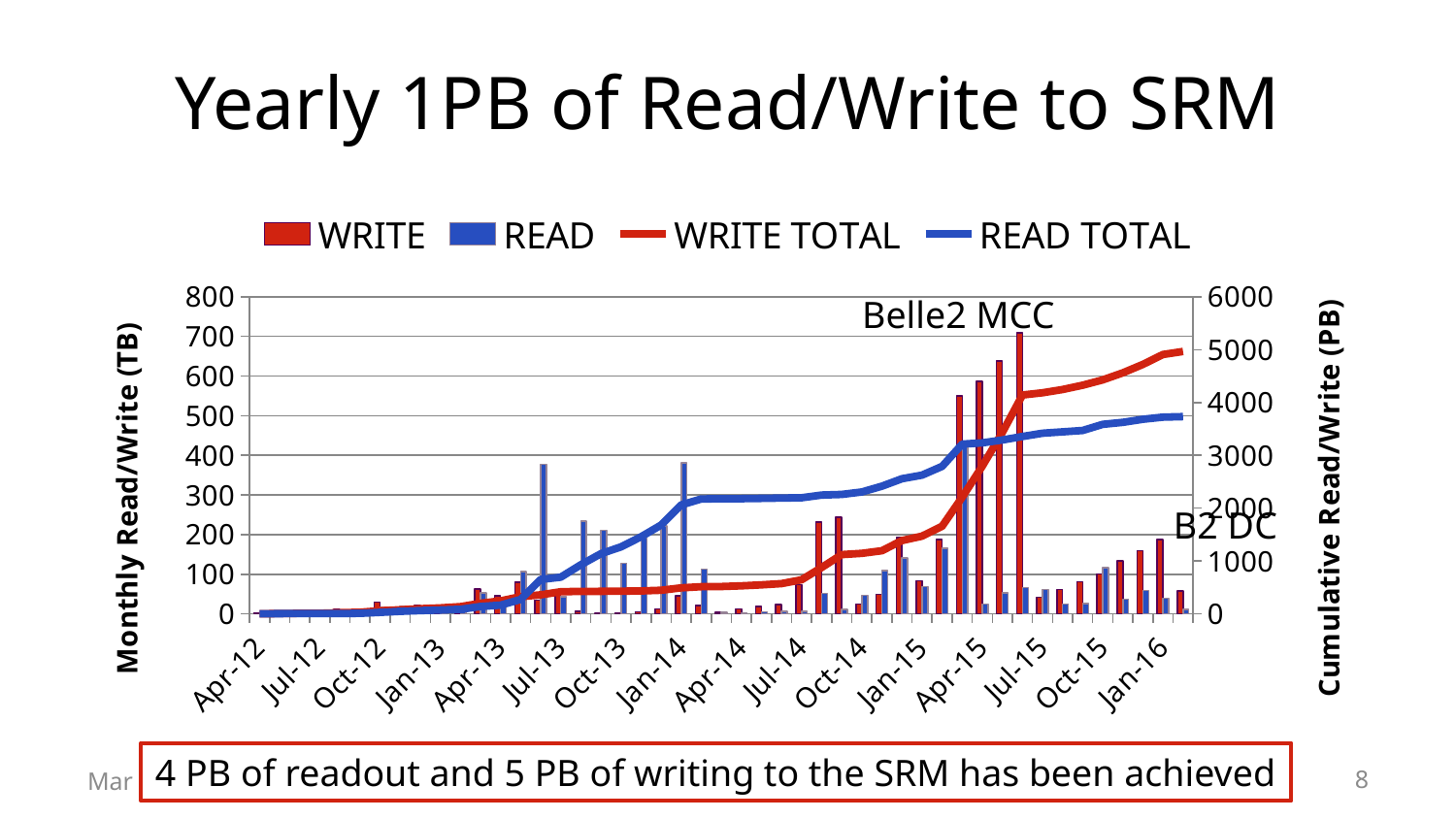
How many date labels are shown on the x axis? 16 Is the WRITE TOTAL value at Jan-15 greater or less than 1000? greater Is the READ TOTAL value at Jan-16 greater or less than 4000? less Does the WRITE TOTAL line rise or fall from Apr-12 to Jan-16? Rises Is the WRITE TOTAL value at Jan-16 greater or less than 4000? greater What kind of chart is shown on the slide? Combined bar and line chart What is the label of the right-hand vertical axis? Cumulative Read/Write (PB) At Jan-14, which cumulative line is higher, WRITE TOTAL or READ TOTAL? READ TOTAL At Jan-16, which cumulative line is higher, WRITE TOTAL or READ TOTAL? WRITE TOTAL Is the tallest bar in the chart a WRITE bar or a READ bar? WRITE How many series does the chart legend list? 4 What is the title of the slide containing the chart? Yearly 1PB of Read/Write to SRM